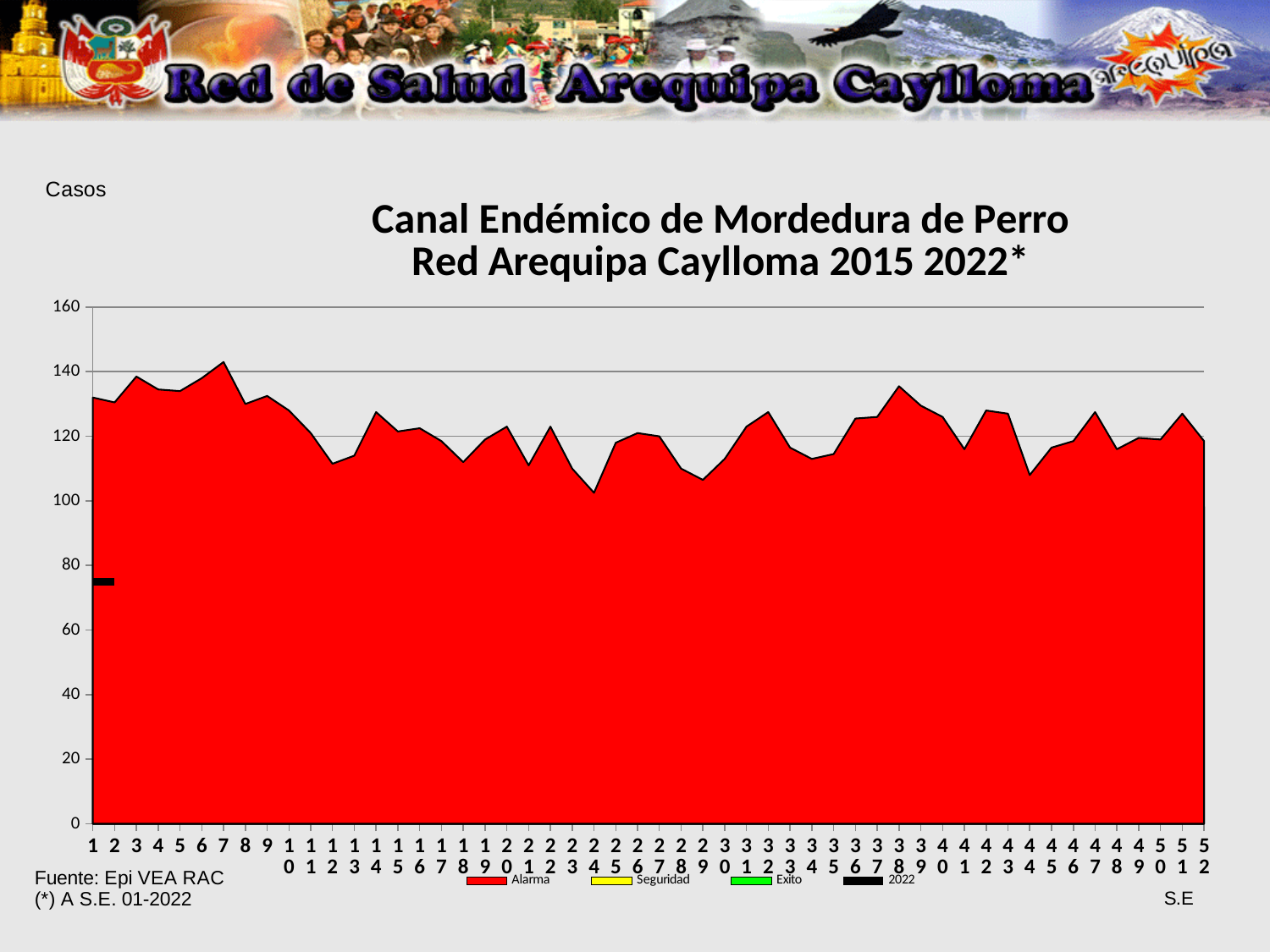
How many series does the legend list? 4 What is the title of the chart? Canal Endémico de Mordedura de Perro Red Arequipa Caylloma 2015 2022* What kind of chart is shown on the slide? Area chart Is the Alarma value for week 34 greater or less than 120? less Is the Alarma value for week 1 greater or less than 120? greater Which has the larger Alarma value, week 7 or week 34? Week 7 Which colour represents the Alarma series in the legend? Red Is the Alarma value for week 7 greater or less than 140? greater How many epidemiological weeks (S.E.) are shown along the x axis? 52 At which week does the Alarma series reach its highest value? 7 Do the Alarma values rise or fall from week 7 to week 13? Fall